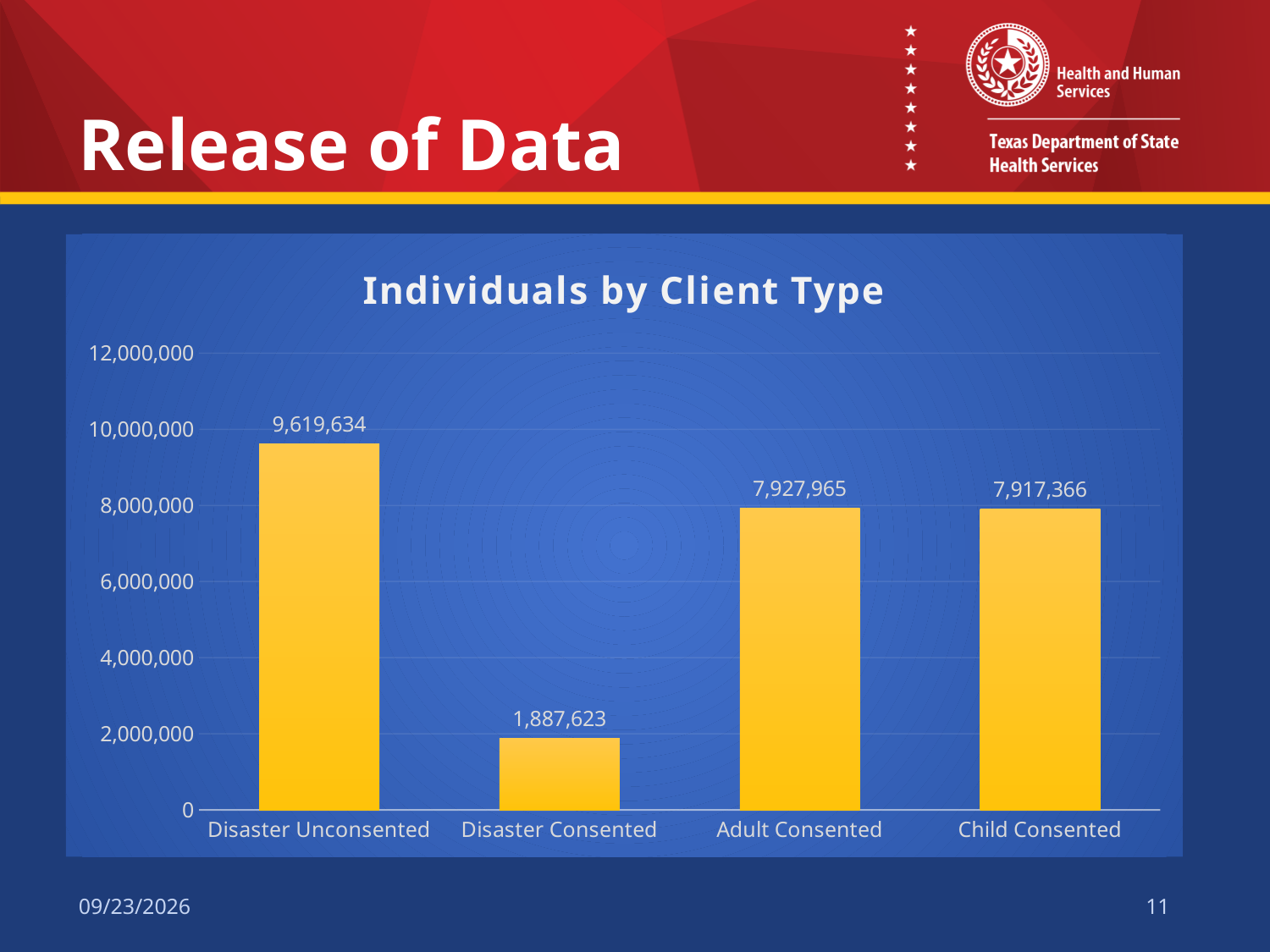
How many client types are shown in the chart? 4 What is the difference between Disaster Unconsented and Disaster Consented? 7,732,011 Which client type has the lowest number of individuals? Disaster Consented Is the value for Disaster Consented greater or less than 2,000,000? less What kind of chart is shown on the slide? Bar chart What is the difference between Adult Consented and Child Consented? 10,599 What is the value for Disaster Consented? 1,887,623 What is the value for Child Consented? 7,917,366 What is the value for Adult Consented? 7,927,965 Which is larger, Disaster Unconsented or Adult Consented? Disaster Unconsented What is the value for Disaster Unconsented in the Individuals by Client Type chart? 9,619,634 Which client type has the highest number of individuals? Disaster Unconsented